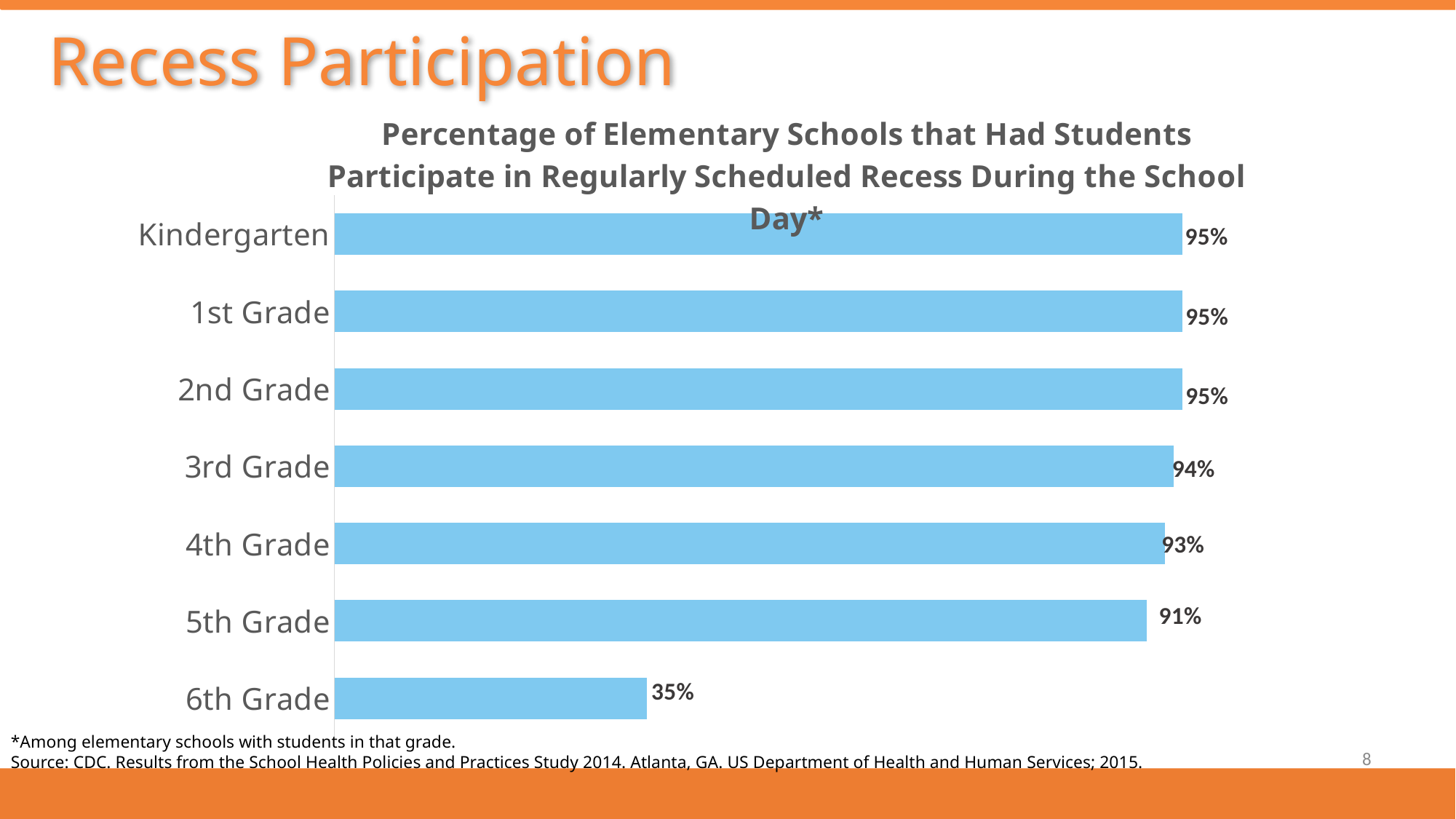
What is the value shown for 4th Grade? 93% Which grade has the lowest recess participation percentage? 6th Grade What is the value shown for 5th Grade? 91% Do the values rise or fall going from Kindergarten down to 6th Grade? Fall How many grade categories are shown in the chart? 7 What is the difference between the values for 5th Grade and 6th Grade? 56% What is the difference between the values for Kindergarten and 4th Grade? 2% What colour are the bars in the chart? Light blue What kind of chart is shown on the slide? Bar chart What is the value shown for 3rd Grade? 94% What percentage of elementary schools had 6th Grade students participate in regularly scheduled recess? 35% Which is larger, the value for 3rd Grade or the value for 5th Grade? 3rd Grade